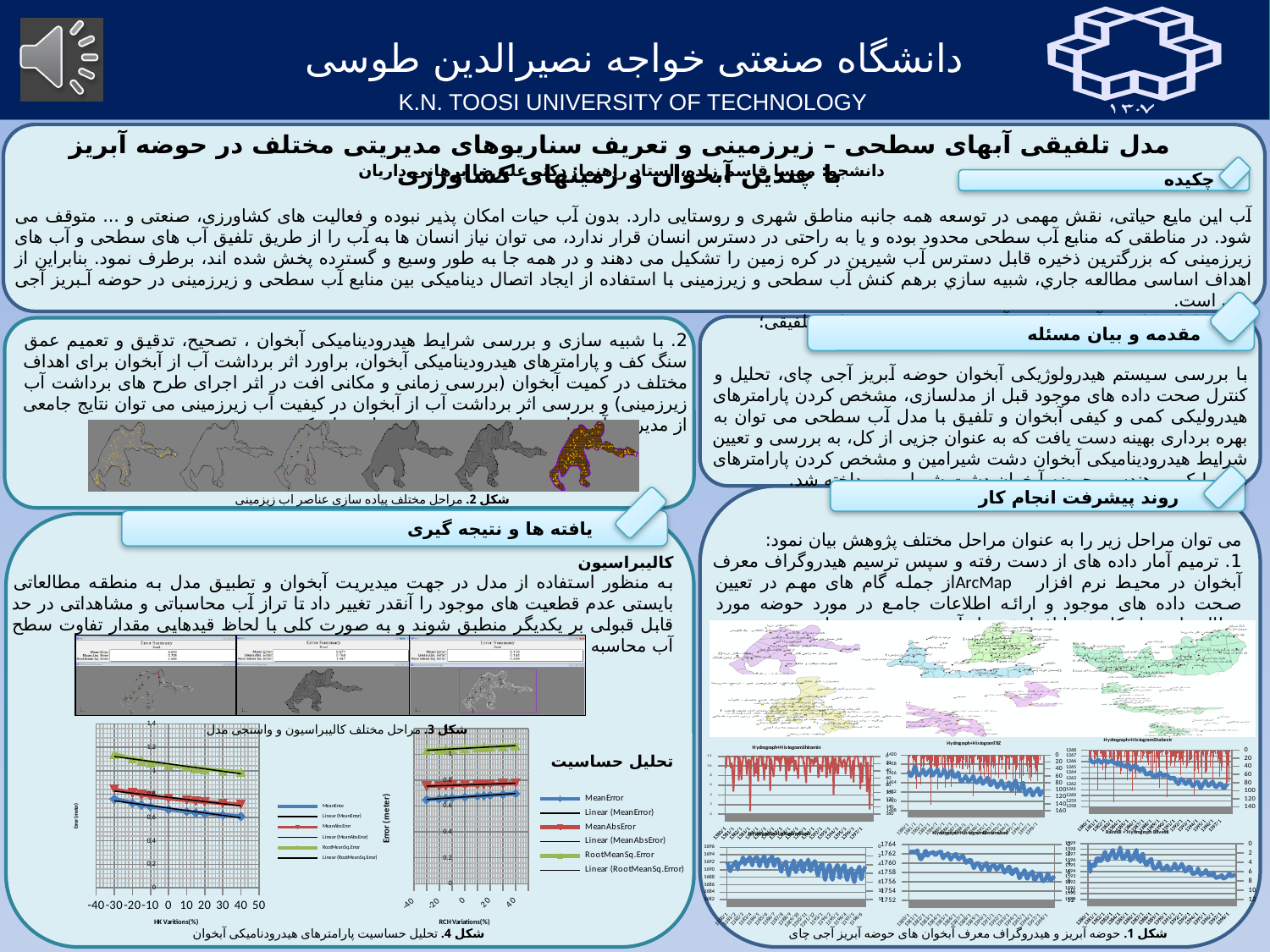
In Figure 4 (sensitivity analysis), what kind of chart is the one with the x-axis labelled "HK Varitions(%)"? line chart In Figure 4, how many entries does the legend of the "HK Varitions(%)" chart list? 6 In Figure 4, what is the y-axis label of the "RCH Variations(%)" chart? Error (meter) How many line charts are shown in Figure 4 (sensitivity analysis)? 2 In Figure 4, in the "RCH Variations(%)" chart, does the RootMeanSq.Error line rise or fall as RCH variation increases? rise In Figure 4, in the "HK Varitions(%)" chart, does the RootMeanSq.Error line rise or fall as HK variation increases? fall In Figure 4, in the "HK Varitions(%)" chart, which series has higher values, RootMeanSq.Error or MeanError? RootMeanSq.Error In Figure 4, in the "RCH Variations(%)" chart, which series has the lowest values? MeanError In Figure 4, in the "RCH Variations(%)" chart, which series has the highest values? RootMeanSq.Error In Figure 4, in the "HK Varitions(%)" chart, is the MeanError value at 40 greater or less than 0.8? less In Figure 4, what colour is the MeanAbsError line? red